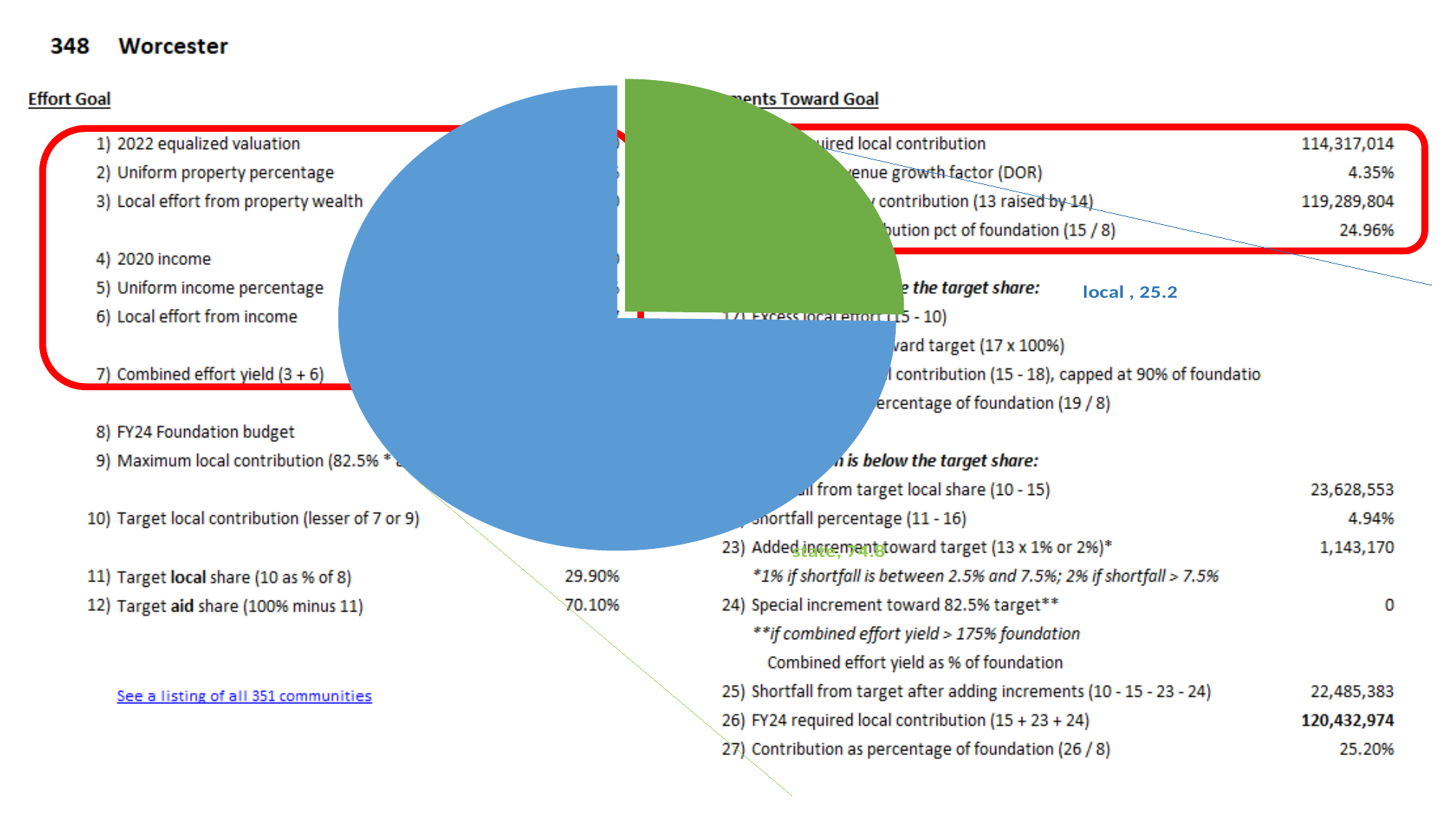
Which slice of the pie chart is the smallest? local Which is larger in the pie chart, the local slice or the state slice? state What colour is the state slice of the pie chart? blue What colour is the local slice of the pie chart? green What is the value shown for the state slice of the pie chart? 74.8 Which slice of the pie chart is the largest? state What kind of chart is shown on the slide? pie chart What is the difference between the state value and the local value in the pie chart? 49.6 What is the value shown for the local slice of the pie chart? 25.2 How many slices does the pie chart have? 2 What is the total of the two slice values in the pie chart? 100